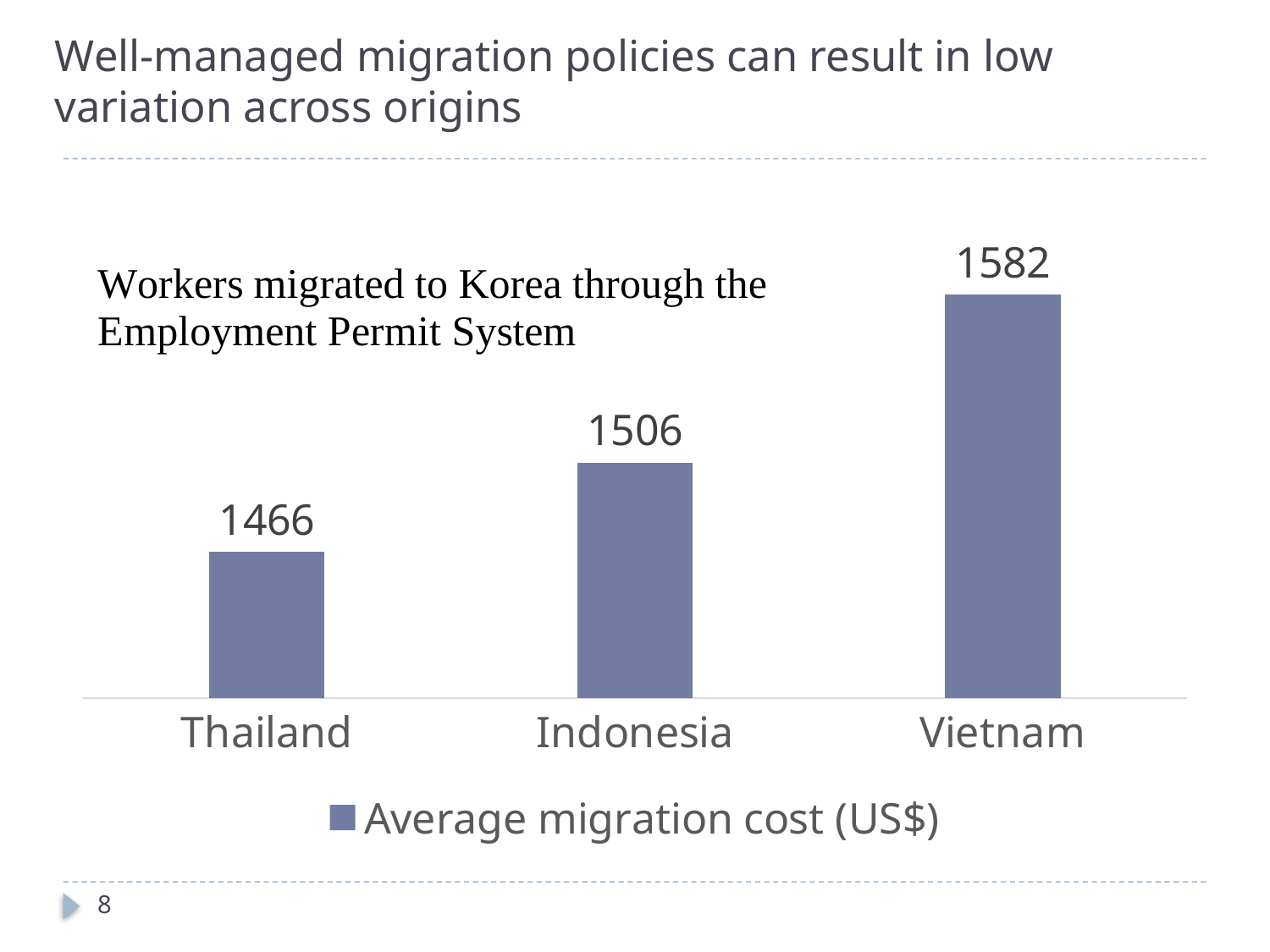
Which has a higher average migration cost, Indonesia or Vietnam? Vietnam How many countries are shown in the chart? 3 Which country has the lowest average migration cost? Thailand What is the average migration cost for Thailand? 1466 Which country has the highest average migration cost? Vietnam Do the values rise or fall from Thailand to Vietnam along the x axis? Rise How many series does the legend list? 1 What is the average migration cost for Vietnam? 1582 What is the difference between the average migration cost for Vietnam and Thailand? 116 What is the average migration cost for Indonesia? 1506 What kind of chart is shown on the slide? Bar chart What is the difference between the average migration cost for Indonesia and Thailand? 40